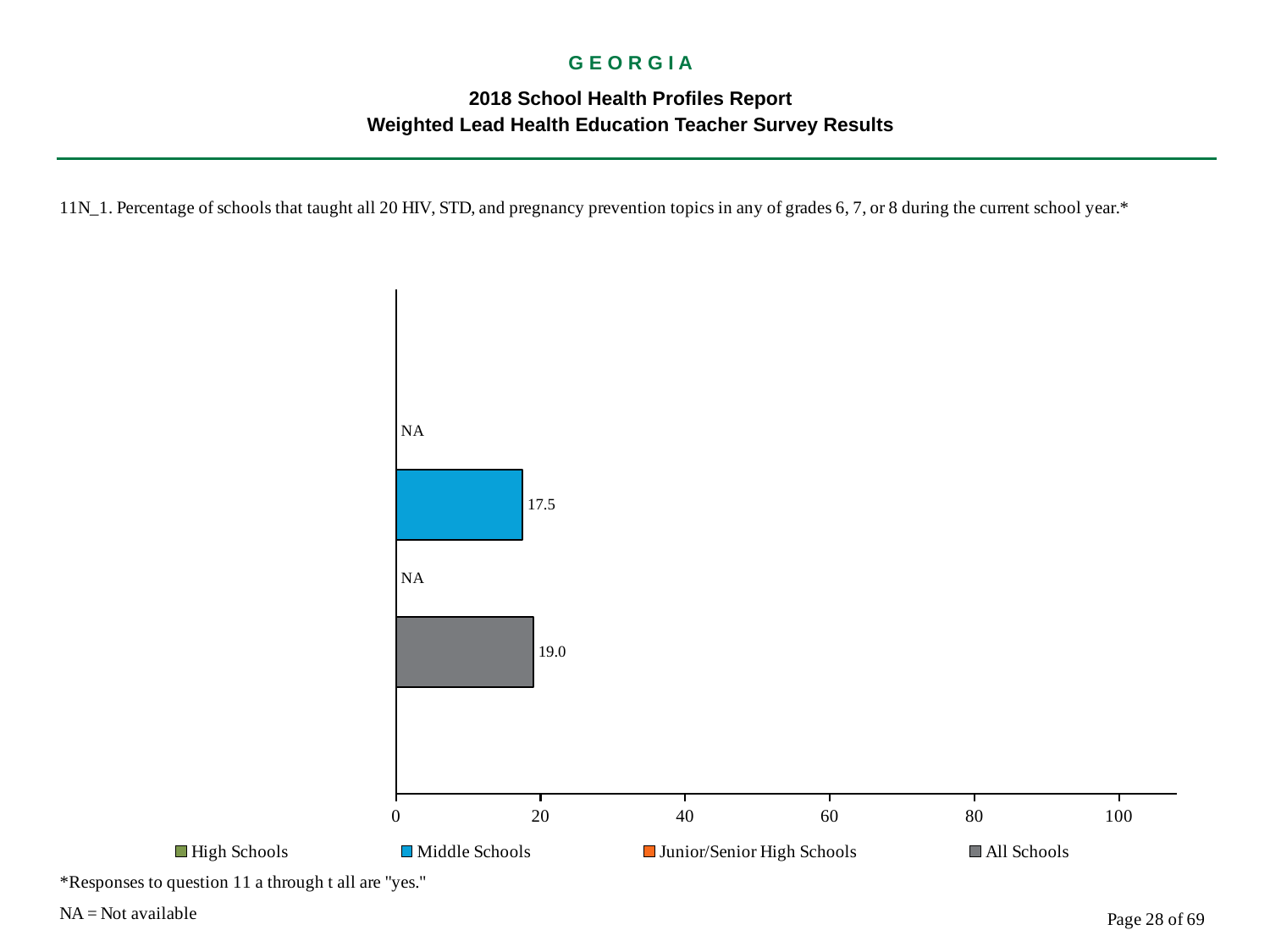
What is the value for Middle Schools? 17.5 What is shown for High Schools? NA What is shown for Junior/Senior High Schools? NA Is the value for Middle Schools greater or less than 20? less How many series does the legend list? 4 Which is larger, the value for Middle Schools or the value for All Schools? All Schools What is the value for All Schools? 19.0 How many series have a plotted bar with a numeric value? 2 What is the difference between the value for All Schools and the value for Middle Schools? 1.5 Is the value for All Schools greater or less than 40? less What is the highest value shown on the x axis? 100 What kind of chart is shown? bar chart